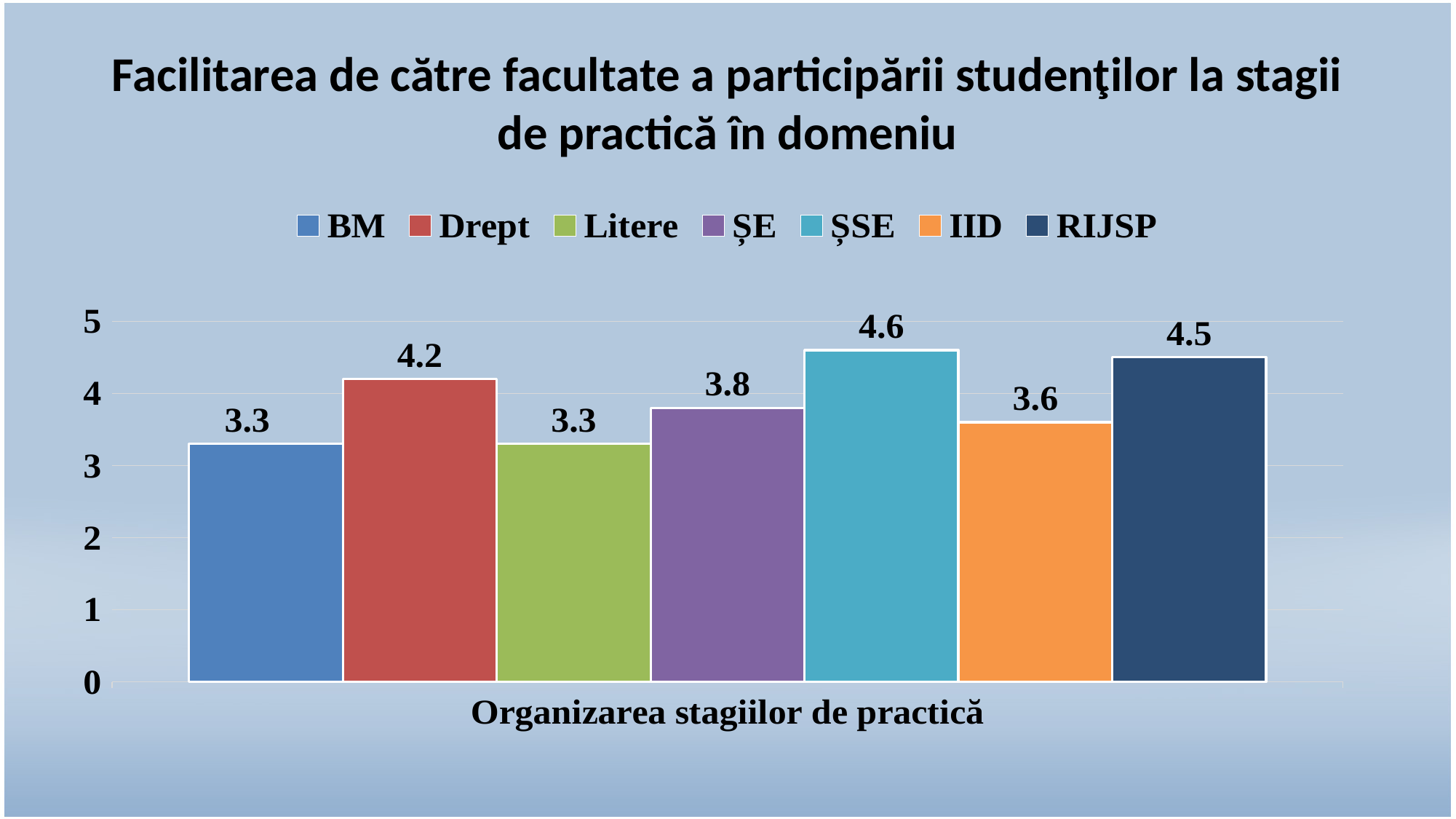
What colour is the bar for RIJSP? dark blue What is the value for Drept? 4.2 What is the difference between the values for RIJSP and BM? 1.2 What is the x-axis category label shown below the bars? Organizarea stagiilor de practică Which series has the highest value? ȘSE How many series does the legend list? 7 What kind of chart is shown? bar chart Which is larger, the value for ȘE or the value for IID? ȘE What is the value for ȘSE? 4.6 Is the value for Litere greater or less than 4? less What is the value for IID? 3.6 What is the difference between the values for ȘSE and Drept? 0.4